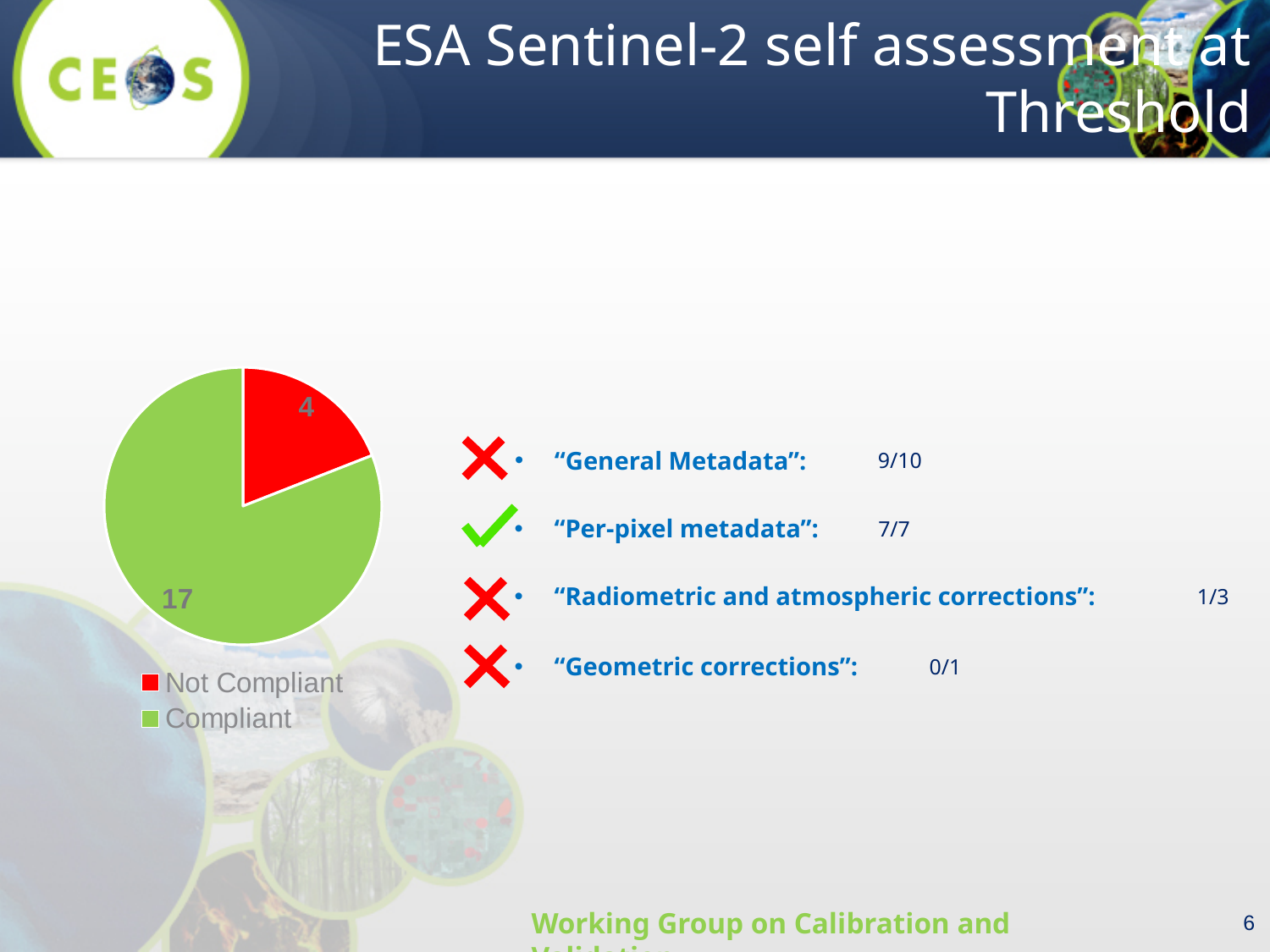
How many categories does the pie chart have? 2 What is the difference between the Compliant and Not Compliant values? 13 What colour represents Compliant in the pie chart? green What is the total of the values shown in the pie chart? 21 What kind of chart is shown on the slide? pie chart Which category has the smallest slice in the pie chart? Not Compliant Which category has the largest slice in the pie chart? Compliant What colour represents Not Compliant in the pie chart? red What is the value for Not Compliant in the pie chart? 4 Which is larger, Compliant or Not Compliant? Compliant What is the value for Compliant in the pie chart? 17